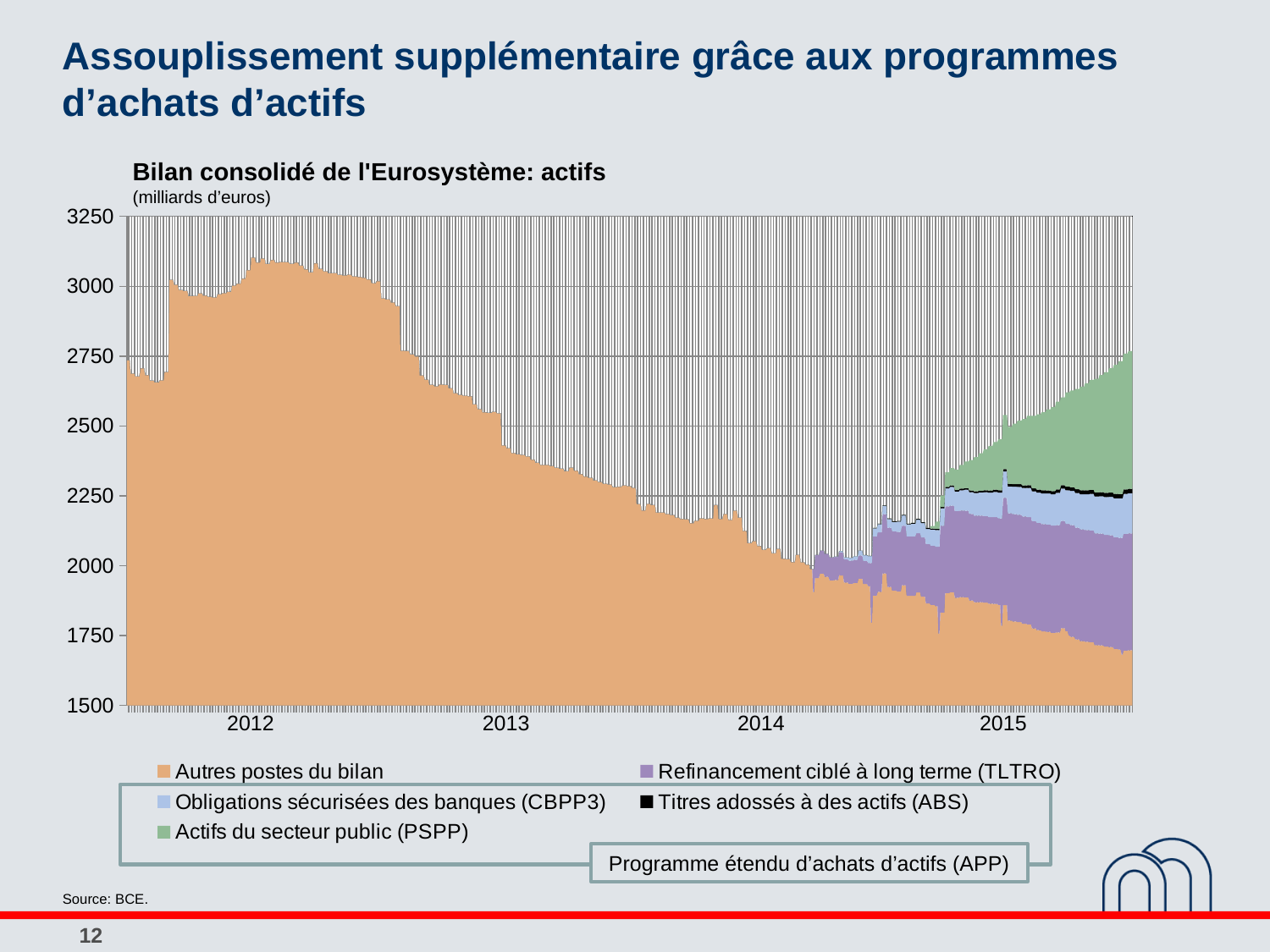
What is the title of the chart? Bilan consolidé de l'Eurosystème: actifs What is the highest value shown on the y axis? 3250 Is the total value at the 2014 mark on the x axis greater or less than 2250? less What is the lowest value shown on the y axis? 1500 Which series is the largest component of the stack throughout the chart? Autres postes du bilan How many year labels are shown on the x axis? 4 Is the total value at the 2012 mark on the x axis greater or less than 2750? greater At the right-hand end of the chart, which is larger: Refinancement ciblé à long terme (TLTRO) or Obligations sécurisées des banques (CBPP3)? Refinancement ciblé à long terme (TLTRO) Is the total value at the right-hand end of the chart (after 2015) greater or less than 2500? greater Does the total balance sheet rise or fall between the 2012 and 2014 marks on the x axis? fall How many series does the legend list? 5